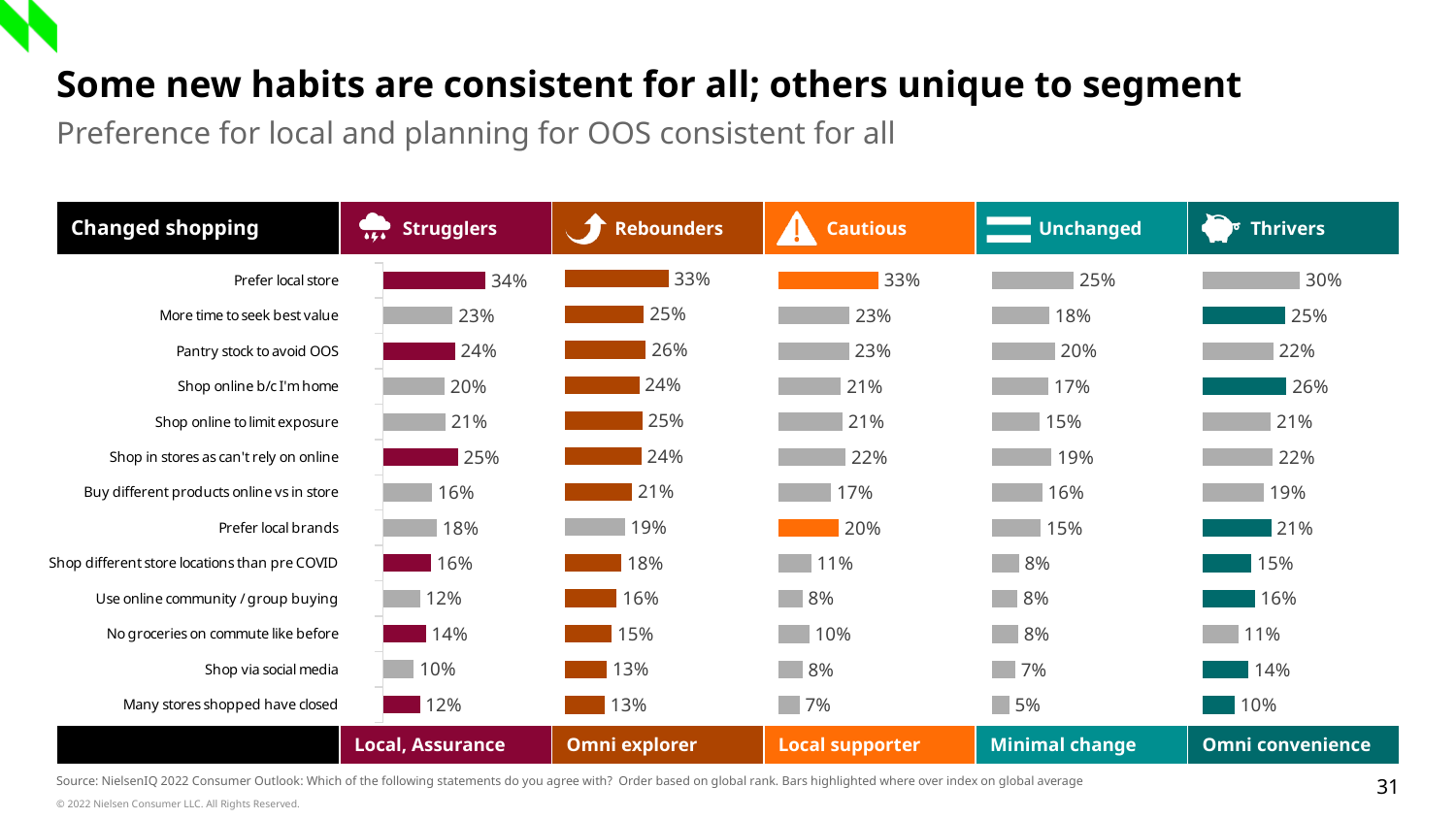
In the Unchanged chart, what is the value for Many stores shopped have closed? 5% How many categories are plotted in the Rebounders chart? 13 What kind of chart is used for each segment on this slide? Bar chart In the Thrivers chart, which category has the highest value? Prefer local store In the Cautious chart, which category has the lowest value? Many stores shopped have closed In the Thrivers chart, which is larger: Shop online b/c I'm home or Shop online to limit exposure? Shop online b/c I'm home In the Thrivers chart, what is the value for Shop online b/c I'm home? 26% In the Strugglers chart, what is the value for Prefer local store? 34% In the Rebounders chart, what is the value for Pantry stock to avoid OOS? 26% In the Strugglers chart, which category has the lowest value? Shop via social media In the Strugglers chart, what is the difference between Prefer local store and Shop via social media? 24 percentage points In the Cautious chart, what is the value for Prefer local brands? 20%